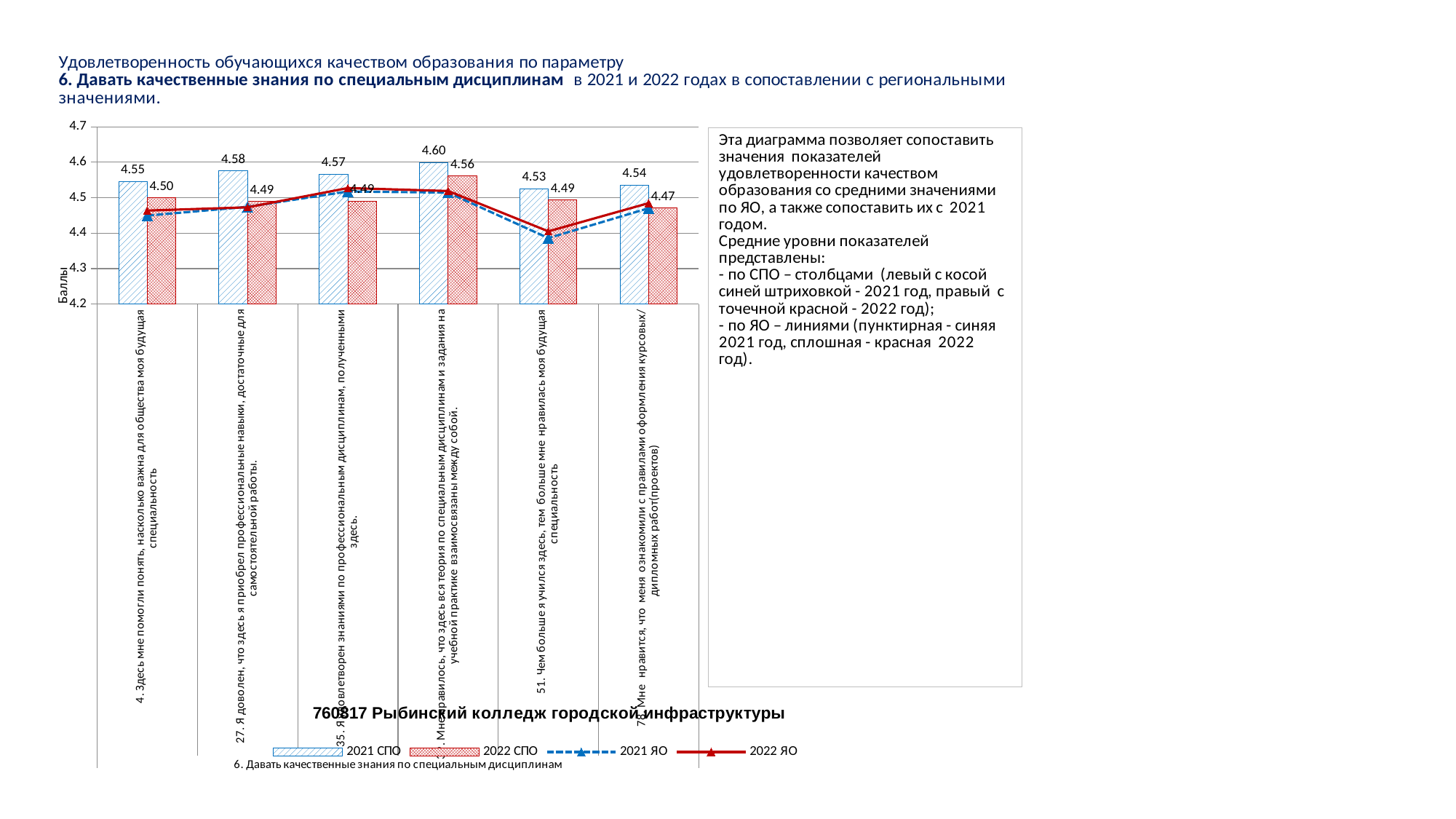
Is the 2021 ЯО value for the category "51. Чем больше я учился здесь, тем больше мне нравилась моя будущая специальность" greater or less than 4.4? less What is the title of the vertical axis of the chart? Баллы What is the difference between the 2021 СПО and 2022 СПО values for the category "4. Здесь мне помогли понять, насколько важна для общества моя будущая специальность"? 0.05 Which category has the lowest 2022 СПО value? Мне нравится, что меня ознакомили с правилами оформления курсовых/дипломных работ(проектов) What is the 2021 СПО value for the category "4. Здесь мне помогли понять, насколько важна для общества моя будущая специальность"? 4.55 Which is larger: the 2021 СПО value for category 27 or the 2021 СПО value for category 51? Category 27 (4.58) How many series does the chart legend list? 4 What is the highest 2022 СПО value shown on the chart? 4.56 Is the 2022 ЯО value for the category "4. Здесь мне помогли понять, насколько важна для общества моя будущая специальность" greater or less than 4.5? less How many categories are shown on the x axis of the chart? 6 What is the 2022 СПО value for the category "51. Чем больше я учился здесь, тем больше мне нравилась моя будущая специальность"? 4.49 What is the 2021 СПО value for the category "27. Я доволен, что здесь я приобрел профессиональные навыки, достаточные для самостоятельной работы"? 4.58